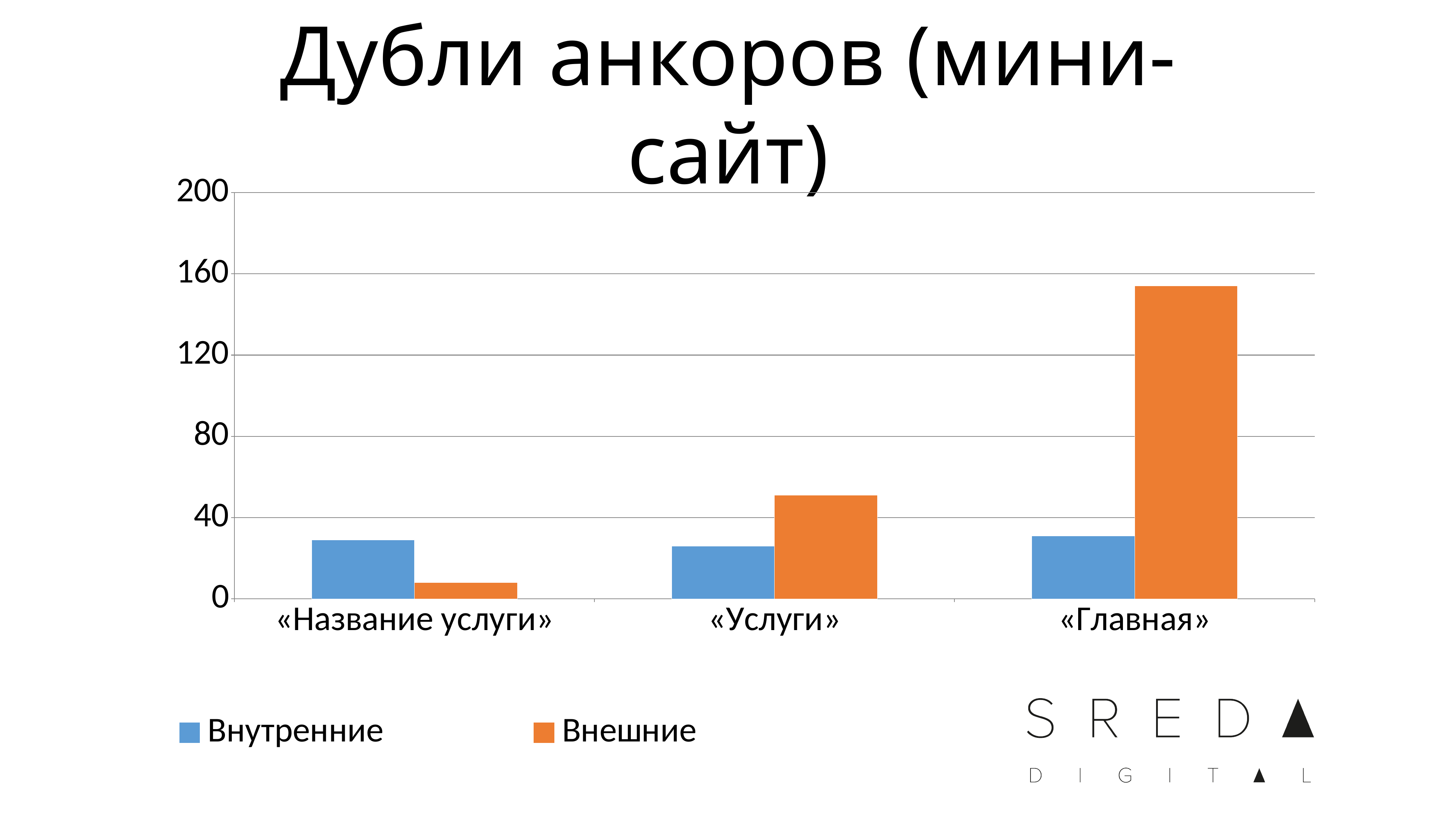
Which colour represents the Внешние series? orange Do the Внешние values rise or fall from «Название услуги» to «Главная»? rise Is the Внешние value for «Название услуги» greater or less than 40? less Is the Внешние value for «Главная» greater or less than 120? greater For which category is the Внешние value highest? «Главная» How many series does the legend list? 2 How many categories are shown on the x axis? 3 For which category is the Внешние value lowest? «Название услуги» For «Название услуги», which is larger: Внутренние or Внешние? Внутренние What kind of chart is shown on the slide? bar chart Is the Внешние value for «Услуги» greater or less than 40? greater What is the title of the chart? Дубли анкоров (мини-сайт)